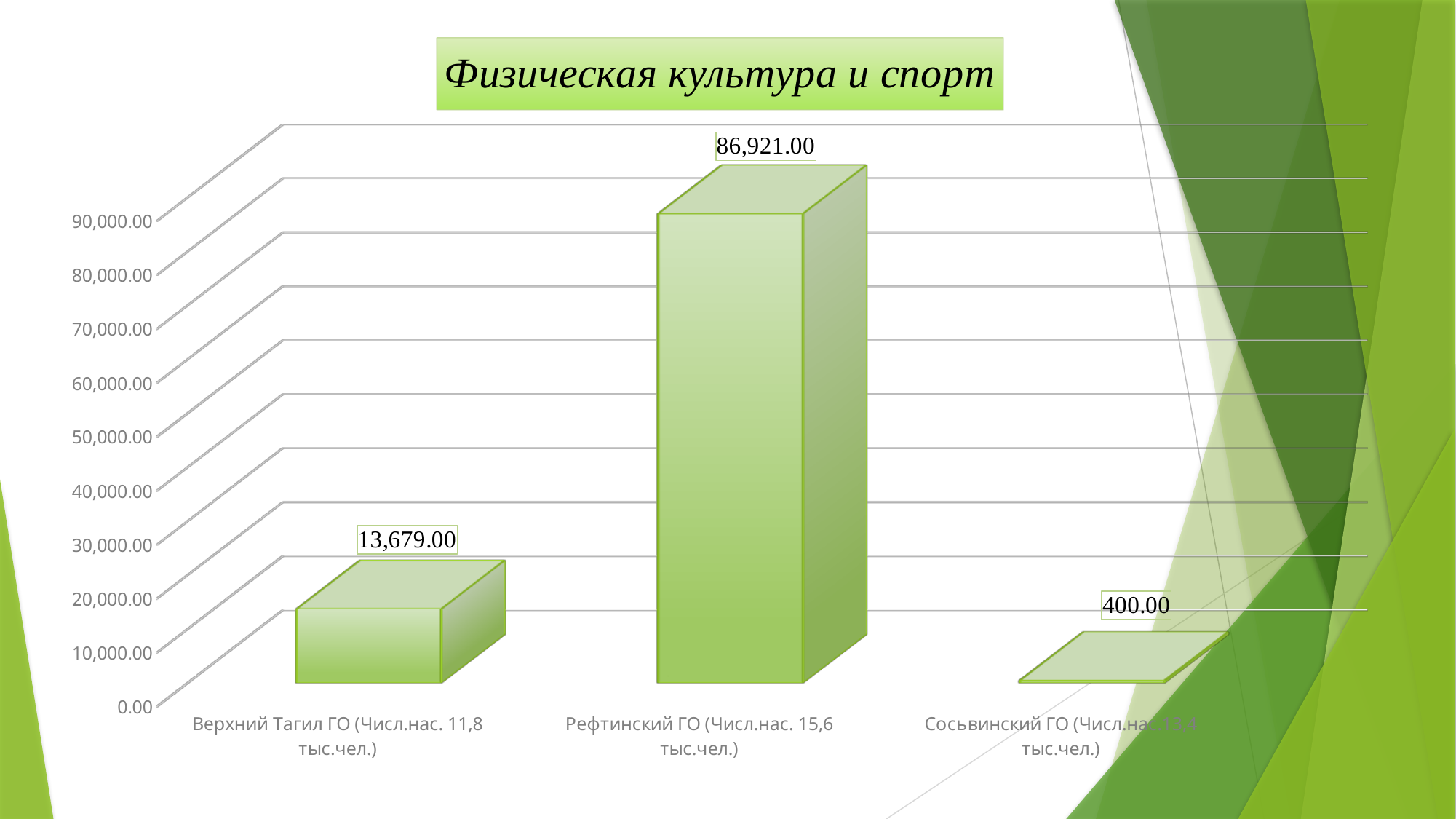
Is the value for Рефтинский ГО greater or less than 80,000.00? greater What is the value for Верхний Тагил ГО? 13,679.00 Which category has the highest value? Рефтинский ГО How many categories are shown in the chart? 3 What is the difference between the values for Рефтинский ГО and Верхний Тагил ГО? 73,242.00 What is the difference between the values for Верхний Тагил ГО and Сосьвинский ГО? 13,279.00 What is the value for Сосьвинский ГО? 400.00 What kind of chart is shown on the slide? bar chart What is the title of the chart? Физическая культура и спорт Which category has the lowest value? Сосьвинский ГО Which is larger, the value for Верхний Тагил ГО or the value for Сосьвинский ГО? Верхний Тагил ГО What is the value for Рефтинский ГО? 86,921.00